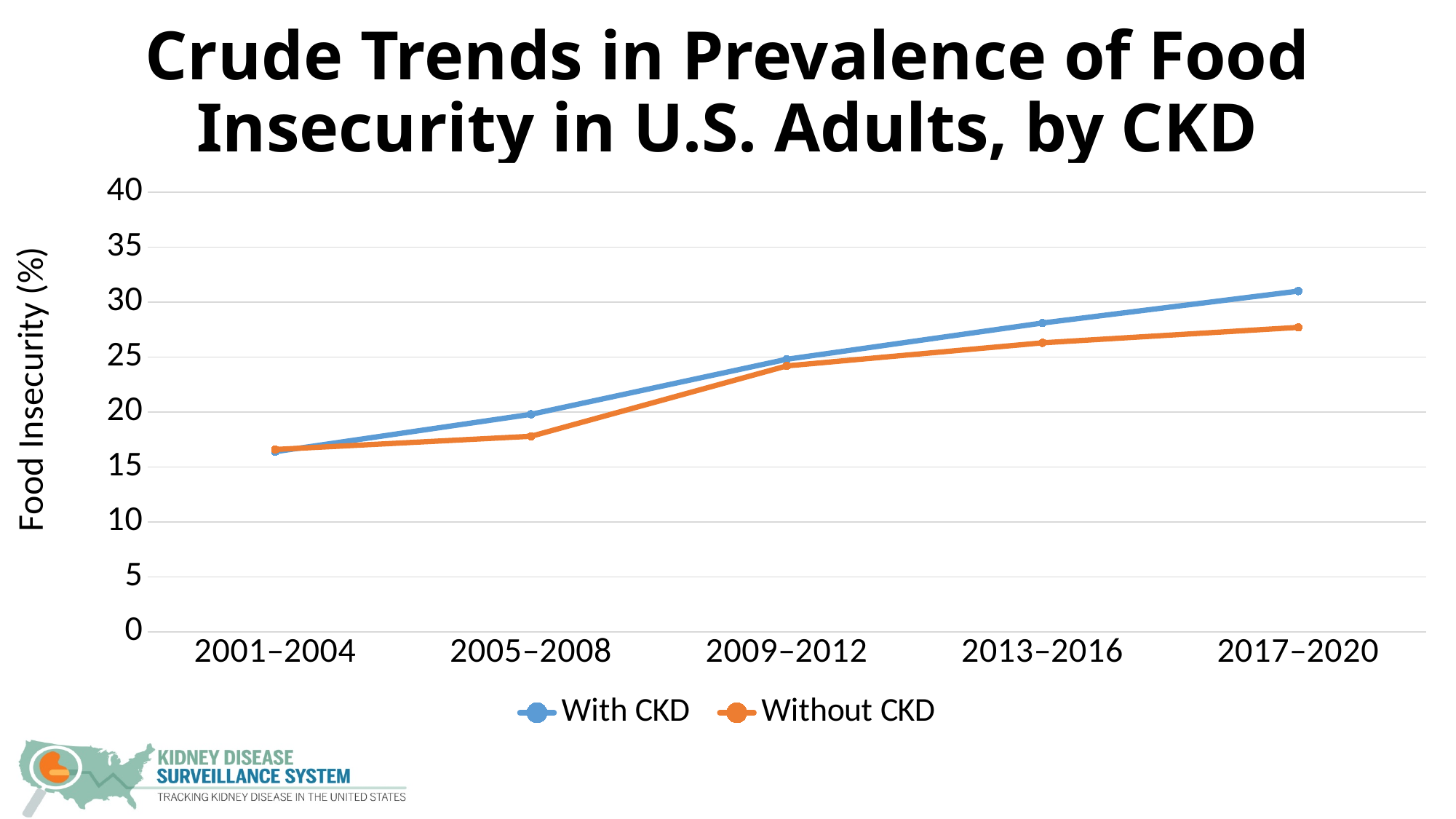
In which period is the value for With CKD highest? 2017–2020 In which period is the value for Without CKD lowest? 2001–2004 How many series does the legend list? 2 What is the label of the y axis? Food Insecurity (%) Is the value for With CKD in 2017–2020 greater or less than 30? greater Is the value for Without CKD in 2005–2008 greater or less than 20? less In 2017–2020, which series has the larger value, With CKD or Without CKD? With CKD How many time periods are shown on the x axis? 5 Do the values for With CKD rise or fall from 2001–2004 to 2017–2020? rise Is the value for Without CKD in 2017–2020 greater or less than 30? less What kind of chart is shown on the slide? line chart